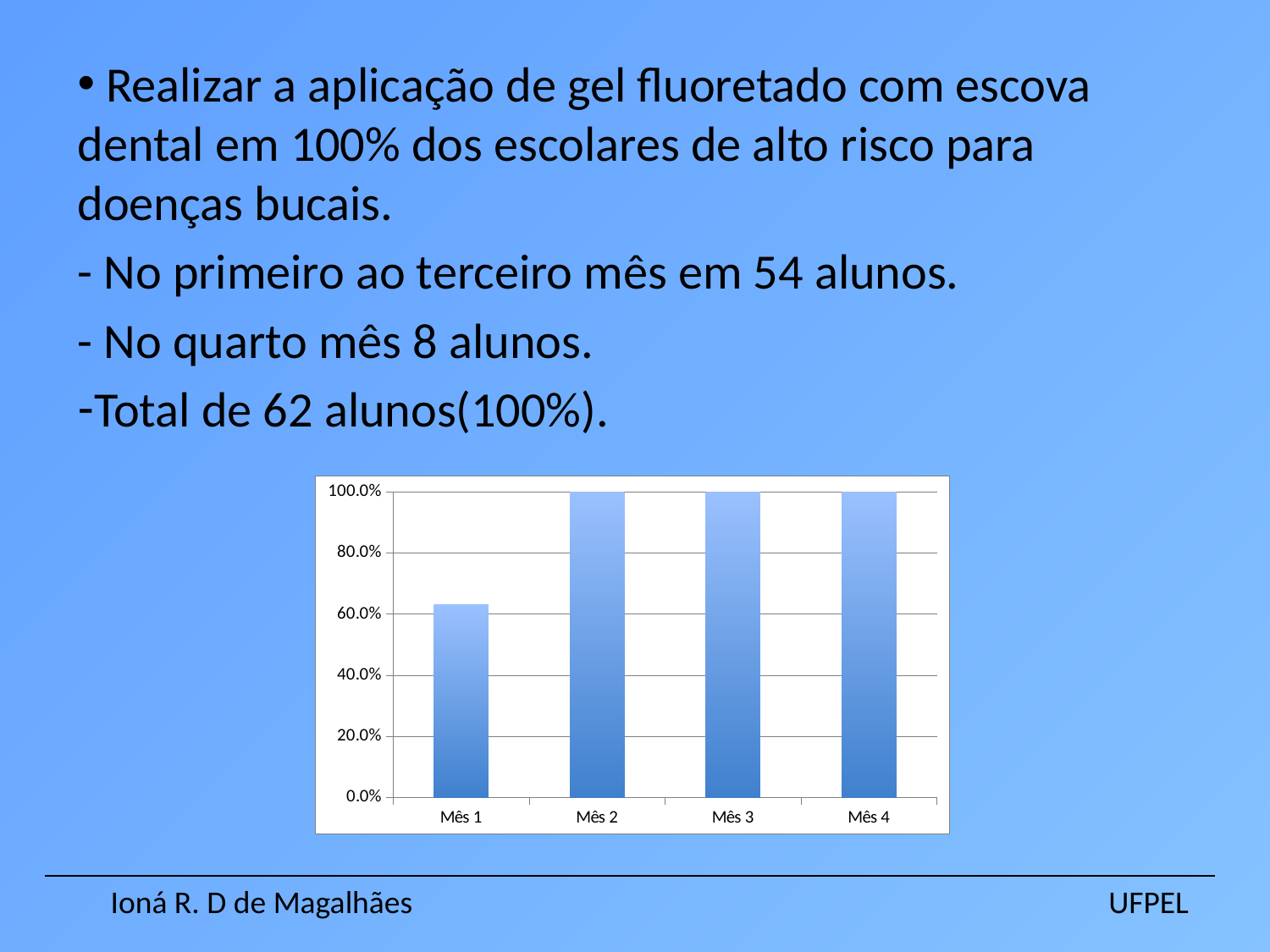
Which is larger, the value for Mês 4 or the value for Mês 1? Mês 4 Is the value for Mês 1 greater or less than 80.0%? less Which is larger, the value for Mês 1 or the value for Mês 2? Mês 2 What is the value for Mês 4 in the chart? 100.0% What is the value for Mês 3 in the chart? 100.0% Does the value rise or fall from Mês 1 to Mês 2? rise What kind of chart is shown on the slide? bar chart What is the value for Mês 2 in the chart? 100.0% Is the value for Mês 1 greater or less than 40.0%? greater Which category has the lowest value in the chart? Mês 1 How many categories are shown on the x axis of the chart? 4 What is the highest value shown on the y axis of the chart? 100.0%